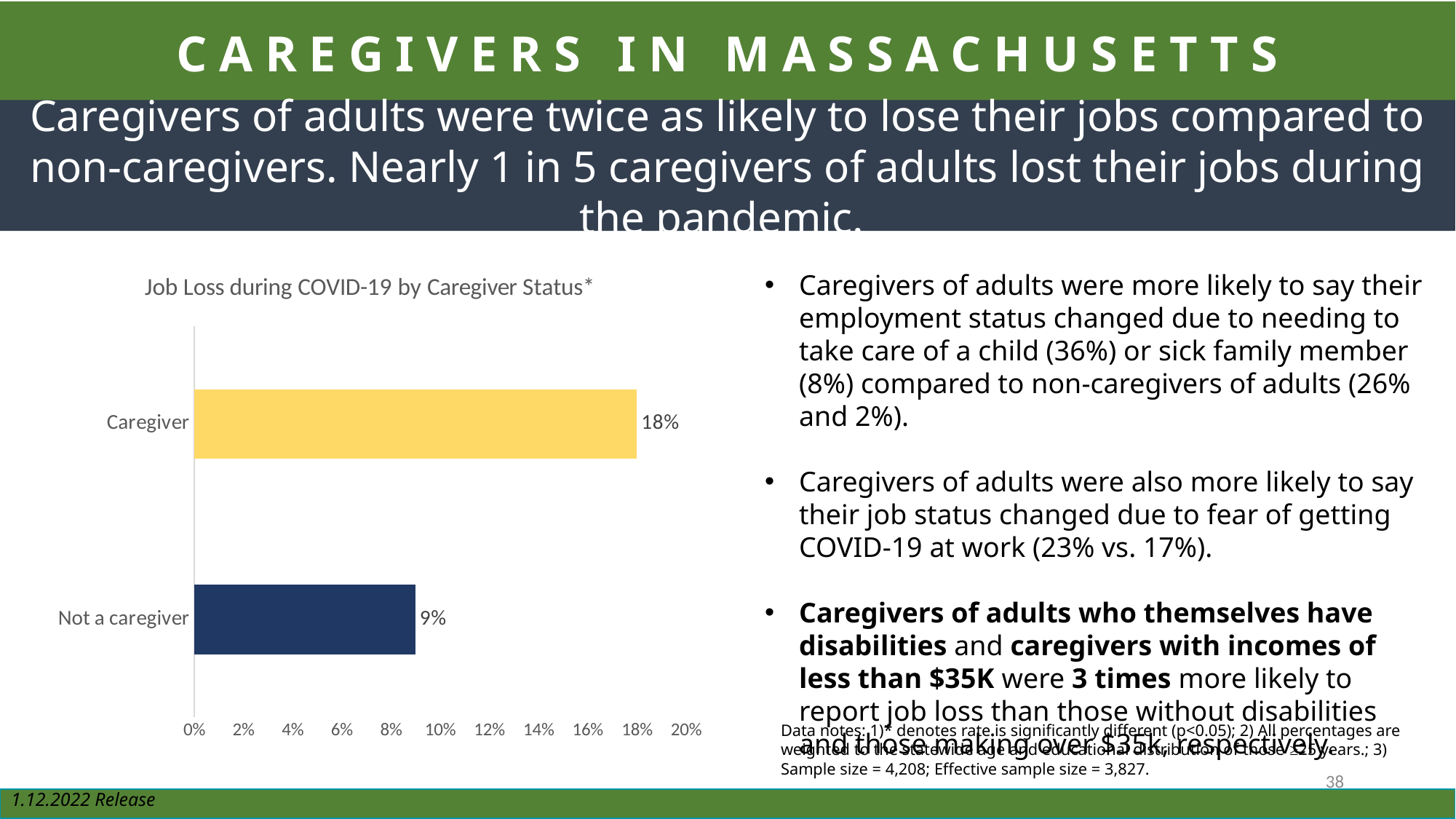
What is the title of the chart? Job Loss during COVID-19 by Caregiver Status* Which category has the lowest job loss percentage? Not a caregiver What is the difference in job loss percentage between Caregiver and Not a caregiver? 9% What kind of chart is shown on the slide? Bar chart What is the job loss percentage for Caregiver? 18% Is the value for Caregiver greater or less than 16%? greater Which has a higher job loss percentage, Caregiver or Not a caregiver? Caregiver What colour is the bar for Caregiver? Yellow What is the job loss percentage for Not a caregiver? 9% How many categories are shown in the chart? 2 Which category has the highest job loss percentage? Caregiver Is the value for Not a caregiver greater or less than 10%? less